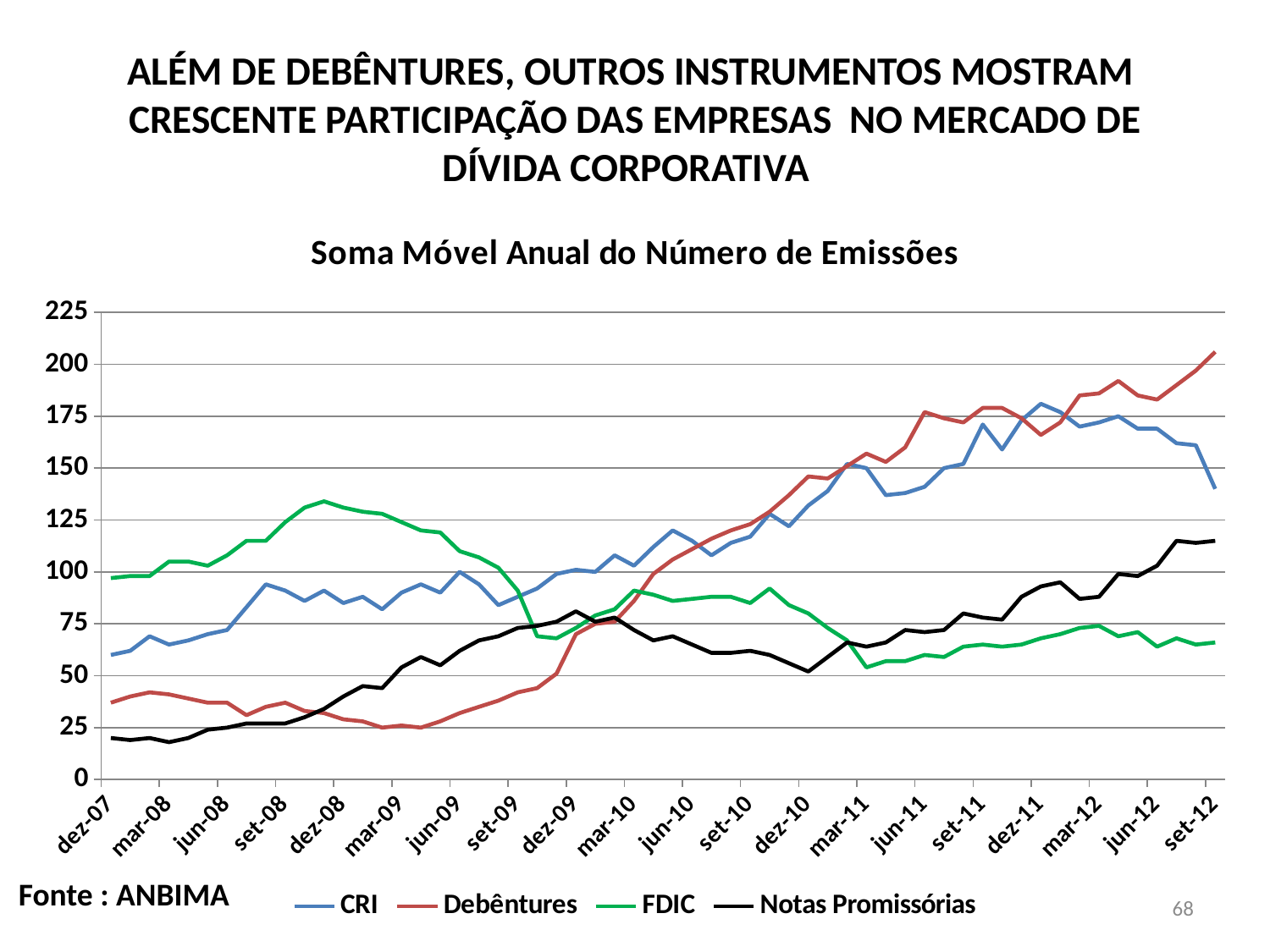
Which series is drawn in black in the chart? Notas Promissórias At set-12, which series is higher: Notas Promissórias or FDIC? Notas Promissórias Which series has the lowest value at dez-07? Notas Promissórias How many series does the legend list? 4 Does the Debêntures series rise or fall from mar-09 to set-12? rise What is the title of the chart? Soma Móvel Anual do Número de Emissões Is the value for Debêntures at mar-09 greater or less than 50? less What kind of chart is shown on the slide? Line chart Is the value for Notas Promissórias at dez-07 greater or less than 25? less At dez-08, which series is higher: FDIC or Debêntures? FDIC Is the value for Debêntures at set-12 greater or less than 175? greater Which series has the highest value at set-12? Debêntures